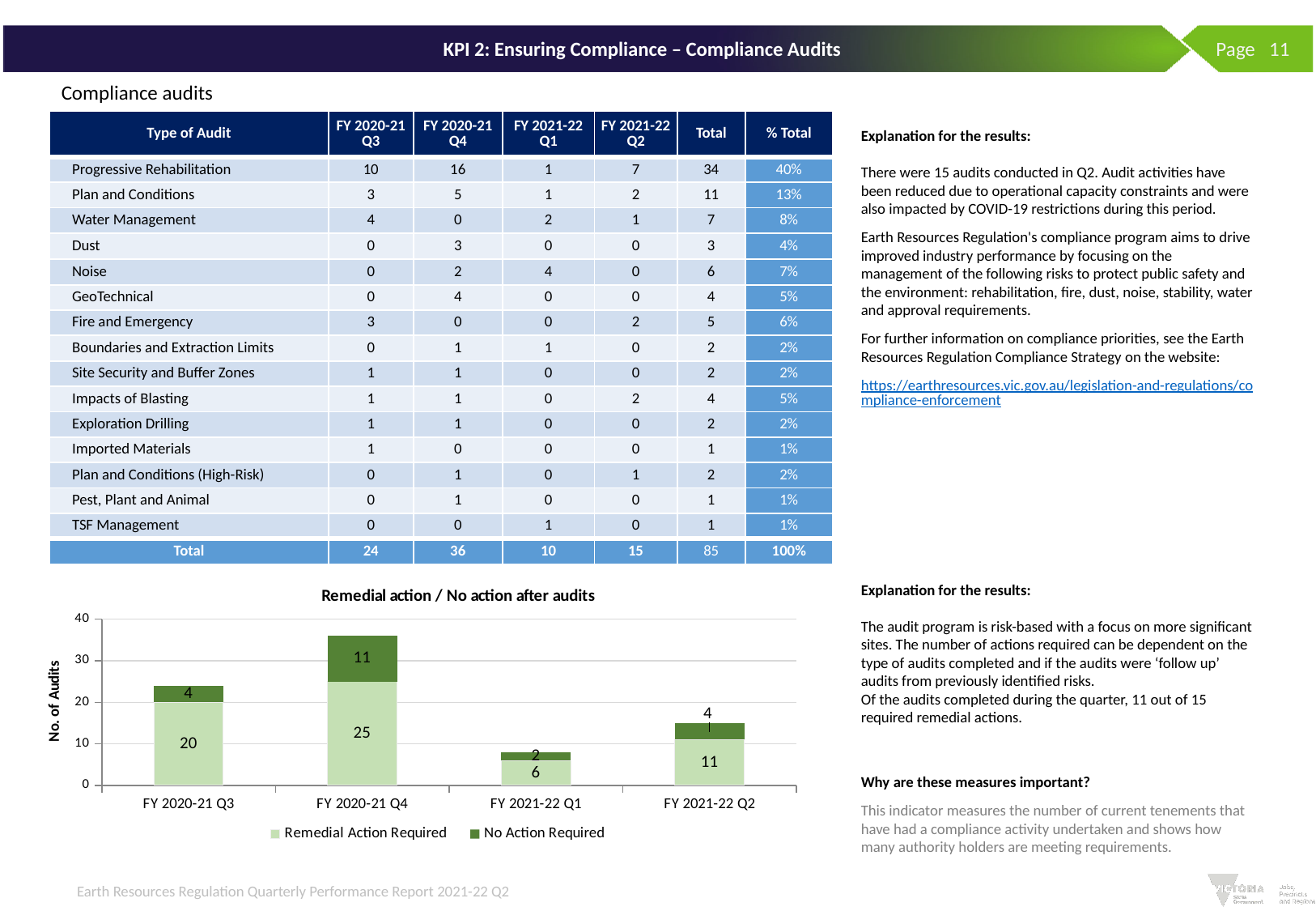
In the 'Remedial action / No action after audits' chart, is the total stacked bar for FY 2020-21 Q4 greater or less than 30? greater How many series does the legend of the 'Remedial action / No action after audits' chart list? 2 In the 'Remedial action / No action after audits' chart, which quarter has the highest Remedial Action Required value? FY 2020-21 Q4 In the 'Remedial action / No action after audits' chart, which quarter has the lowest No Action Required value? FY 2021-22 Q1 How many quarters are shown on the x axis of the 'Remedial action / No action after audits' chart? 4 What type of chart is 'Remedial action / No action after audits'? stacked bar chart In the 'Remedial action / No action after audits' chart, is the Remedial Action Required value larger for FY 2020-21 Q3 or FY 2021-22 Q2? FY 2020-21 Q3 In the 'Remedial action / No action after audits' chart, what is the No Action Required value for FY 2021-22 Q1? 2 In the 'Remedial action / No action after audits' chart, what is the Remedial Action Required value for FY 2021-22 Q2? 11 In the 'Remedial action / No action after audits' chart, what is the difference between the Remedial Action Required values for FY 2020-21 Q3 and FY 2021-22 Q1? 14 In the 'Remedial action / No action after audits' chart, what is the Remedial Action Required value for FY 2020-21 Q4? 25 In the 'Remedial action / No action after audits' chart, what is the total height of the stacked bar for FY 2020-21 Q4? 36